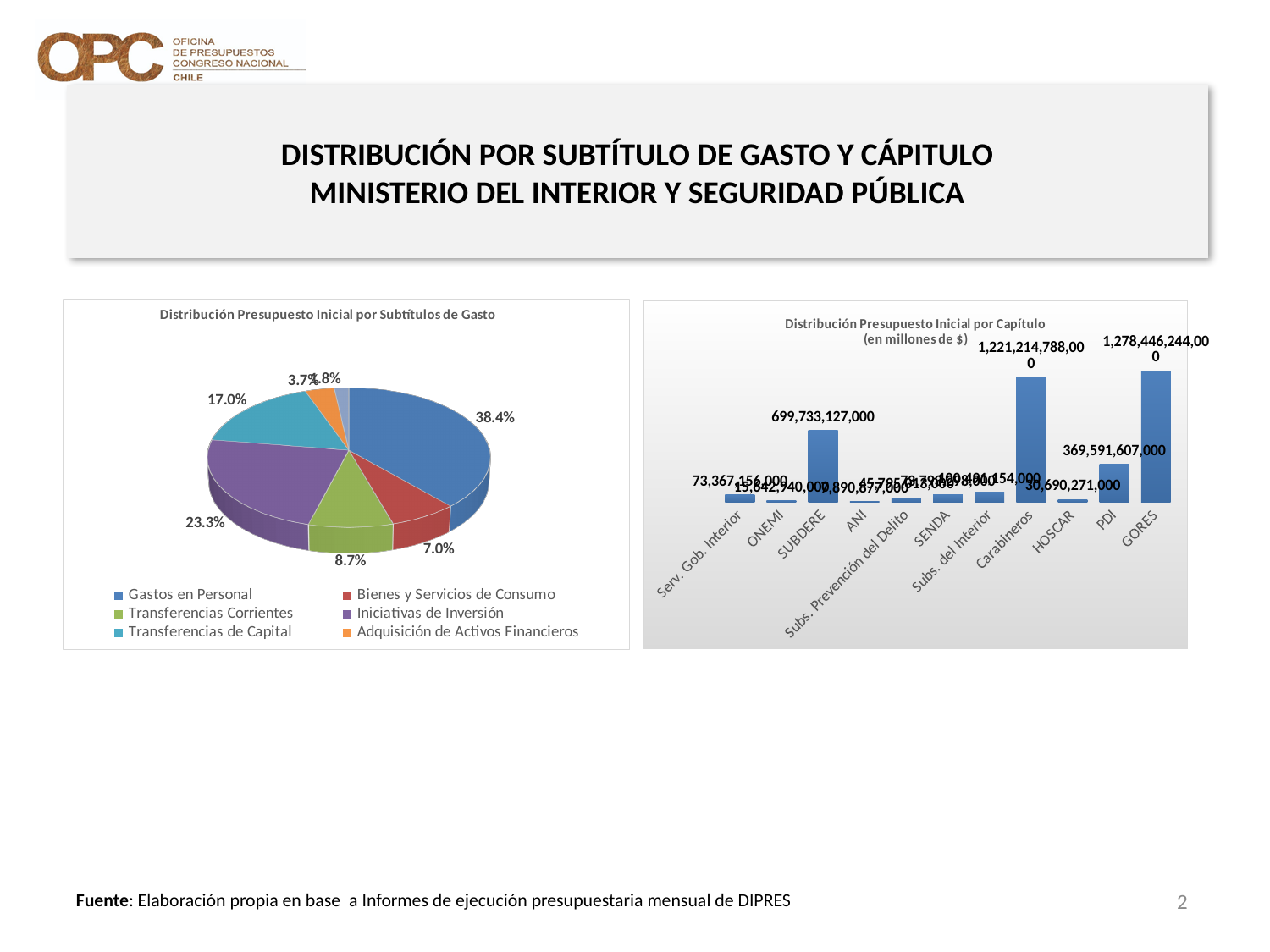
In the left pie chart, what share does Transferencias de Capital have? 17.0% In the right bar chart, which capítulo has the highest value? GORES What kind of chart is the left chart, 'Distribución Presupuesto Inicial por Subtítulos de Gasto'? Pie chart In the right bar chart, what is the value for Carabineros? 1,221,214,788,000 In the left pie chart, what share does Gastos en Personal have? 38.4% How many entries does the legend of the left pie chart list? 6 In the left pie chart, which category has the largest slice? Gastos en Personal In the right bar chart, what is the difference between the values for GORES and Carabineros? 57,231,456,000 In the left pie chart, which is larger: Transferencias Corrientes or Bienes y Servicios de Consumo? Transferencias Corrientes How many capítulos are shown on the x axis of the right bar chart? 11 In the left pie chart, what share does Iniciativas de Inversión have? 23.3% What kind of chart is the right chart, 'Distribución Presupuesto Inicial por Capítulo'? Bar chart